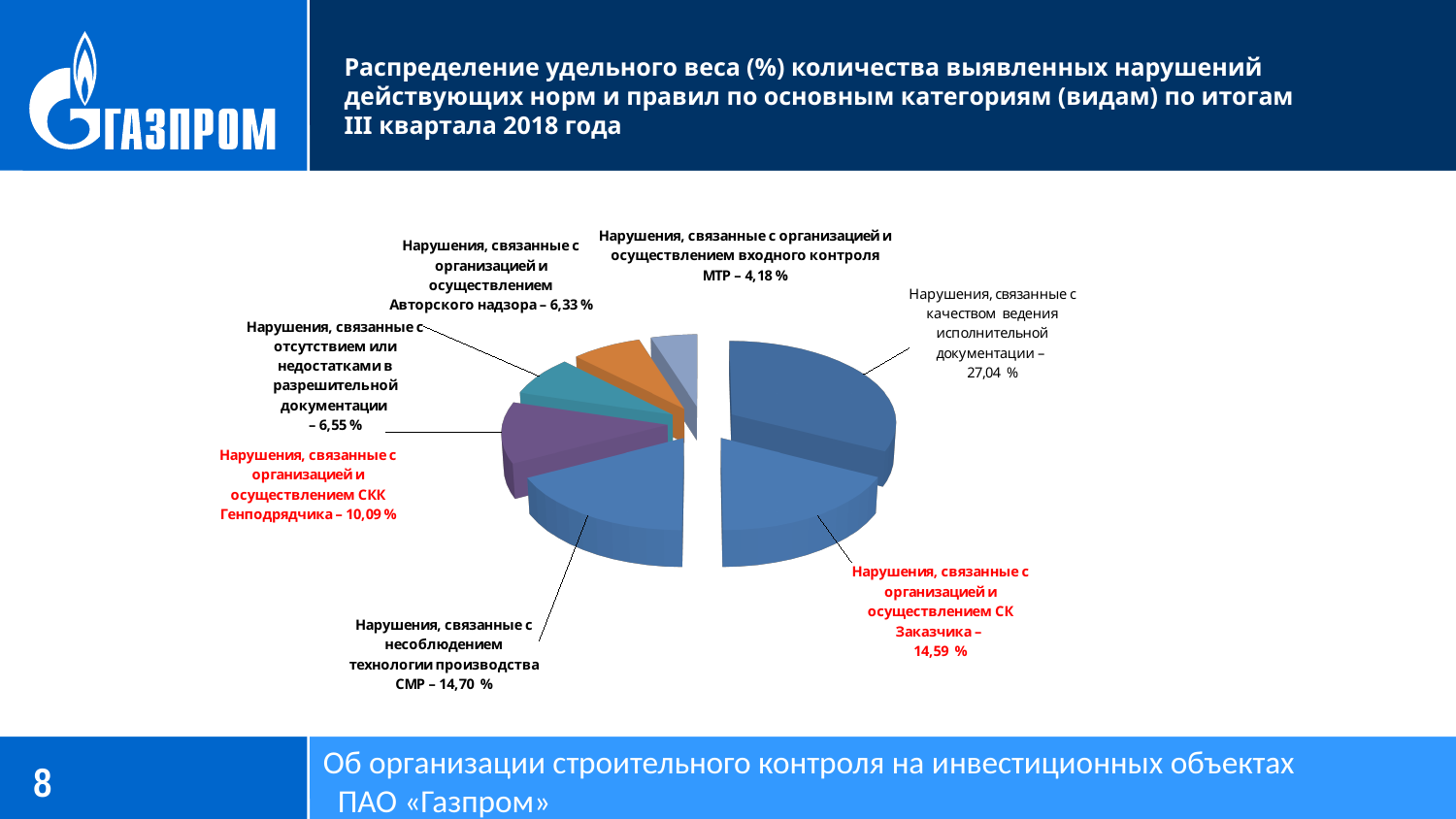
What kind of chart is shown on the slide? Pie chart What is the share for «Нарушения, связанные с организацией и осуществлением входного контроля МТР»? 4,18 % What is the share for «Нарушения, связанные с качеством ведения исполнительной документации»? 27,04 % What is the share for «Нарушения, связанные с несоблюдением технологии производства СМР»? 14,70 % Which is larger: the share for «отсутствием или недостатками в разрешительной документации» or the share for «Авторского надзора»? Отсутствием или недостатками в разрешительной документации (6,55 %) What is the share for «Нарушения, связанные с организацией и осуществлением СК Заказчика»? 14,59 % What is the share for «Нарушения, связанные с организацией и осуществлением СКК Генподрядчика»? 10,09 % How many categories (slices) are shown in the pie chart? 7 What is the difference between the share for «качеством ведения исполнительной документации» (27,04 %) and the share for «СКК Генподрядчика» (10,09 %)? 16,95 % For which quarter and year does the chart title say the distribution is given? III квартала 2018 года Which category has the smallest share of the pie? Нарушения, связанные с организацией и осуществлением входного контроля МТР Which category has the largest share of the pie? Нарушения, связанные с качеством ведения исполнительной документации